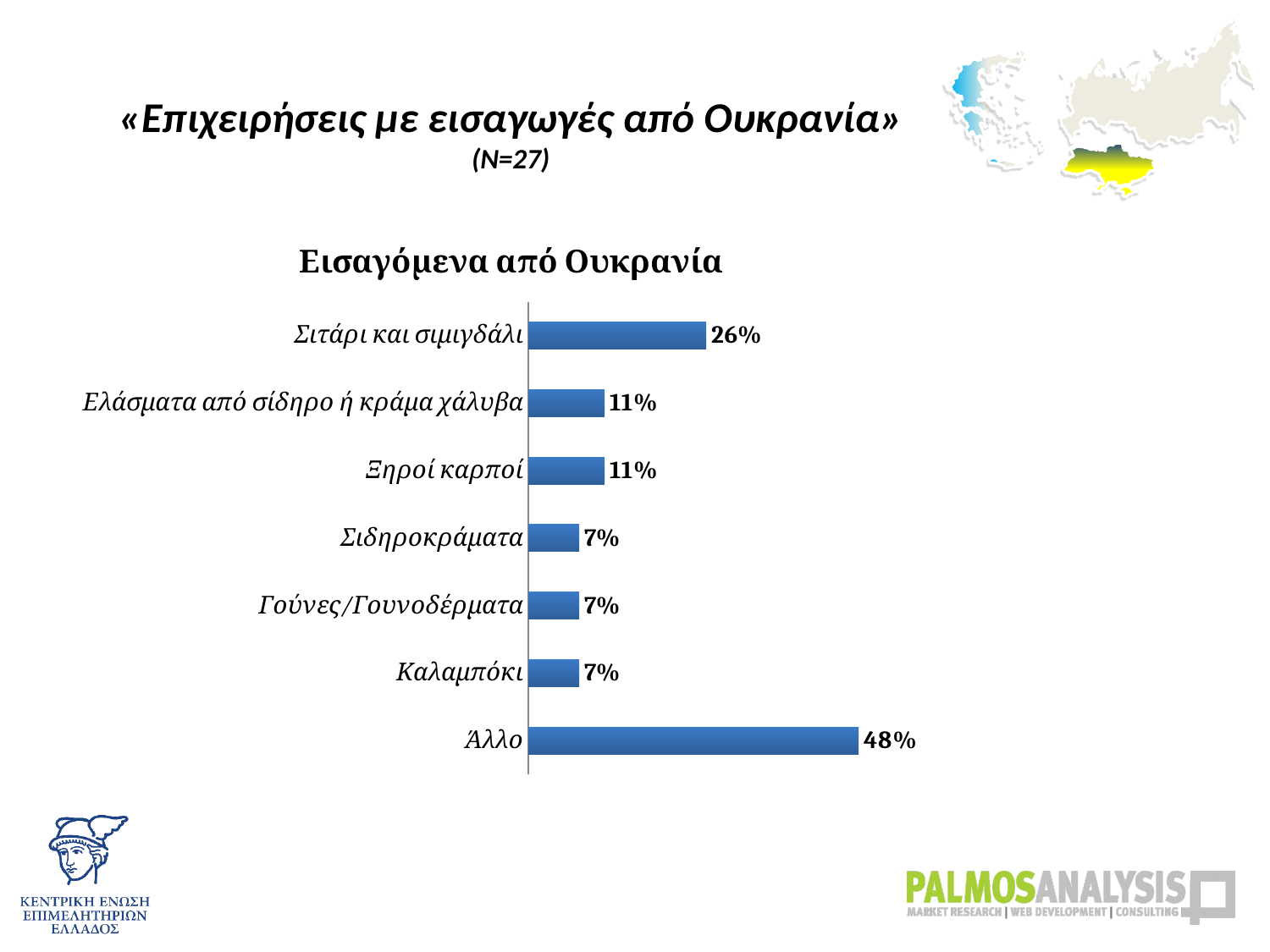
Which category has the highest value? Άλλο What is the value for Καλαμπόκι? 7% What is the value for Ελάσματα από σίδηρο ή κράμα χάλυβα? 11% What is the value for Άλλο? 48% Which is larger, the value for Σιτάρι και σιμιγδάλι or the value for Ξηροί καρποί? Σιτάρι και σιμιγδάλι How many categories are shown in the chart? 7 What is the value for Σιτάρι και σιμιγδάλι? 26% What is the difference between the values for Σιτάρι και σιμιγδάλι and Ξηροί καρποί? 15% What is the title of the chart? Εισαγόμενα από Ουκρανία What is the difference between the values for Άλλο and Σιτάρι και σιμιγδάλι? 22% How many categories share the value 7%? 3 What kind of chart is shown on the slide? bar chart